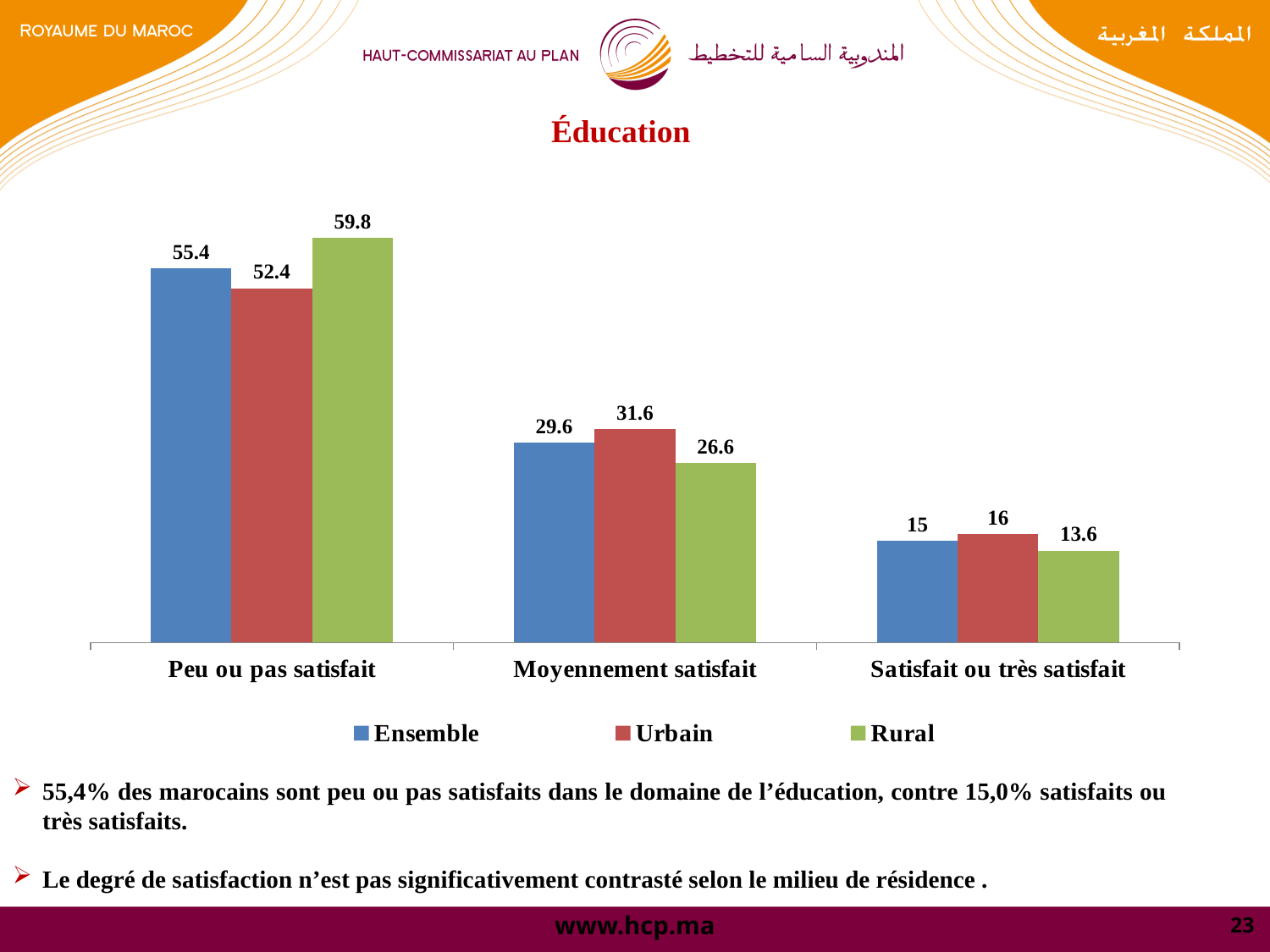
What is the value for Urbain in the 'Moyennement satisfait' category? 31.6 What is the value for Ensemble in the 'Satisfait ou très satisfait' category? 15 What kind of chart is shown on the slide? Bar chart Which is larger: the Ensemble value for 'Moyennement satisfait' or the Rural value for 'Moyennement satisfait'? Ensemble What is the title of the chart? Éducation How many series does the legend list? 3 What is the difference between the Rural and Ensemble values in the 'Peu ou pas satisfait' category? 4.4 What is the value for Rural in the 'Peu ou pas satisfait' category? 59.8 Which series has the highest value in the 'Peu ou pas satisfait' category? Rural How many categories are shown on the x axis? 3 What is the difference between the Urbain and Rural values in the 'Moyennement satisfait' category? 5 Which series has the lowest value in the 'Satisfait ou très satisfait' category? Rural